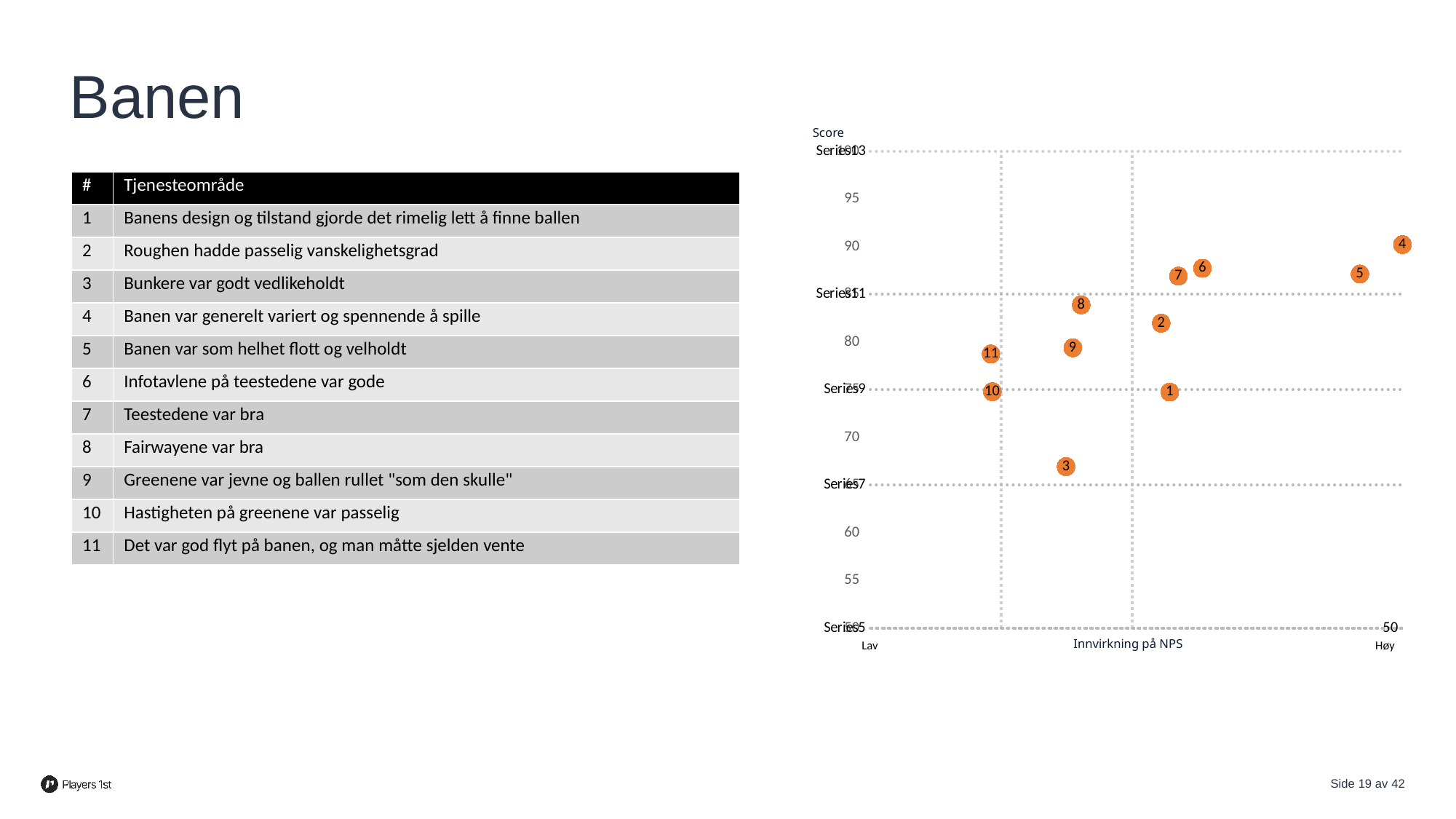
What kind of chart is shown on the slide? scatter chart Which numbered point has the lowest score on the chart? 3 Which numbered point is furthest to the right (highest Innvirkning på NPS) on the chart? 4 How many numbered points are plotted on the chart? 11 What is the title of the horizontal axis of the chart? Innvirkning på NPS Is the score for point 4 greater or less than 85? greater What is the title of the vertical axis of the chart? Score Is the score for point 3 greater or less than 70? less Which has the higher score on the chart, point 6 or point 2? 6 Is the score for point 1 greater or less than 80? less Which numbered point has the highest score on the chart? 4